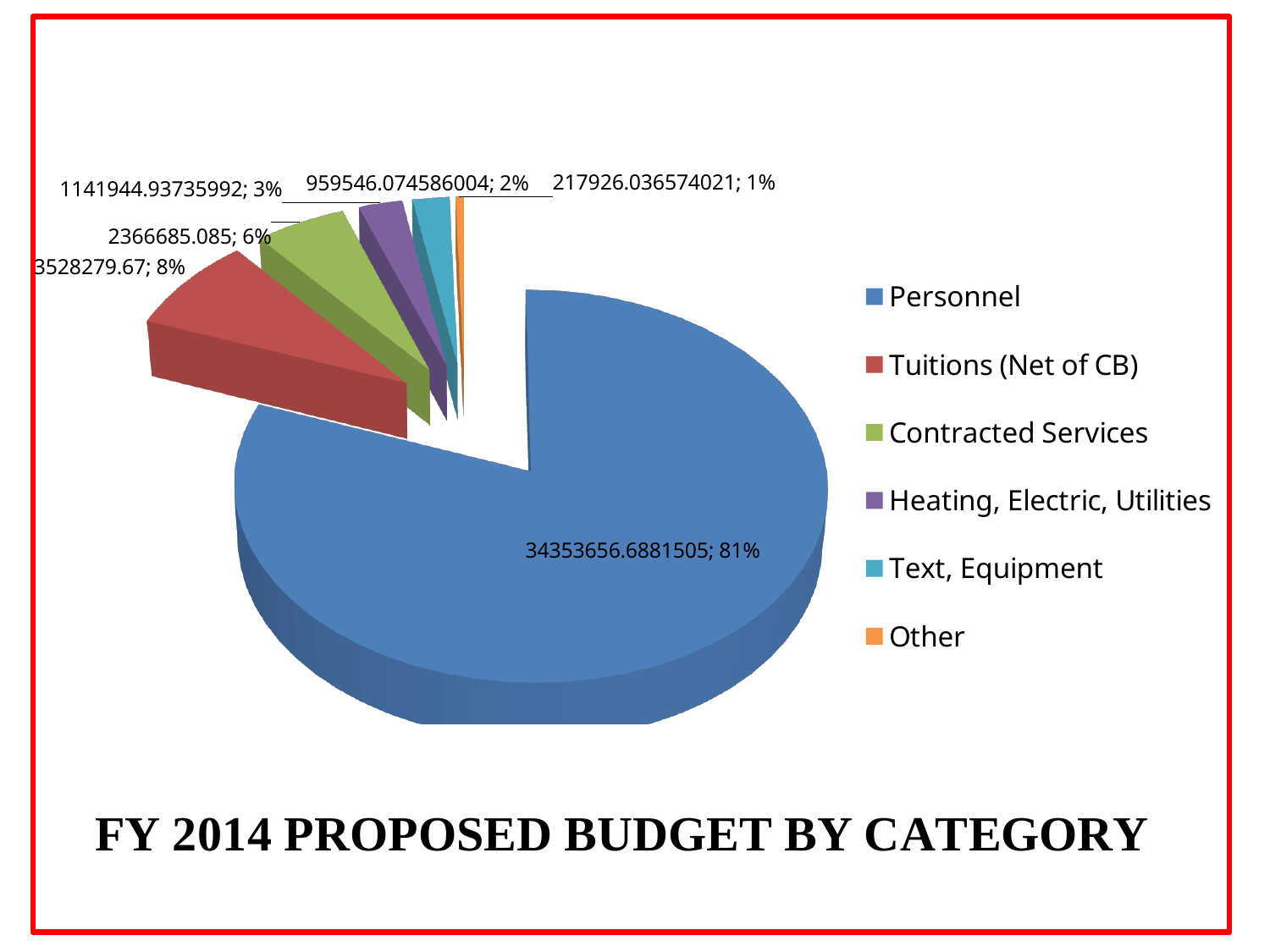
What share of the pie does Contracted Services represent? 6% Which category has the largest slice of the pie? Personnel Which category has the smallest slice of the pie? Other What is the value shown for Contracted Services? 2366685.085 How many categories does the legend list? 6 What share of the pie does Heating, Electric, Utilities represent? 3% What share of the pie does Tuitions (Net of CB) represent? 8% What kind of chart is shown on the slide? pie chart What is the value shown for Personnel? 34353656.6881505 What is the title of the chart? FY 2014 PROPOSED BUDGET BY CATEGORY